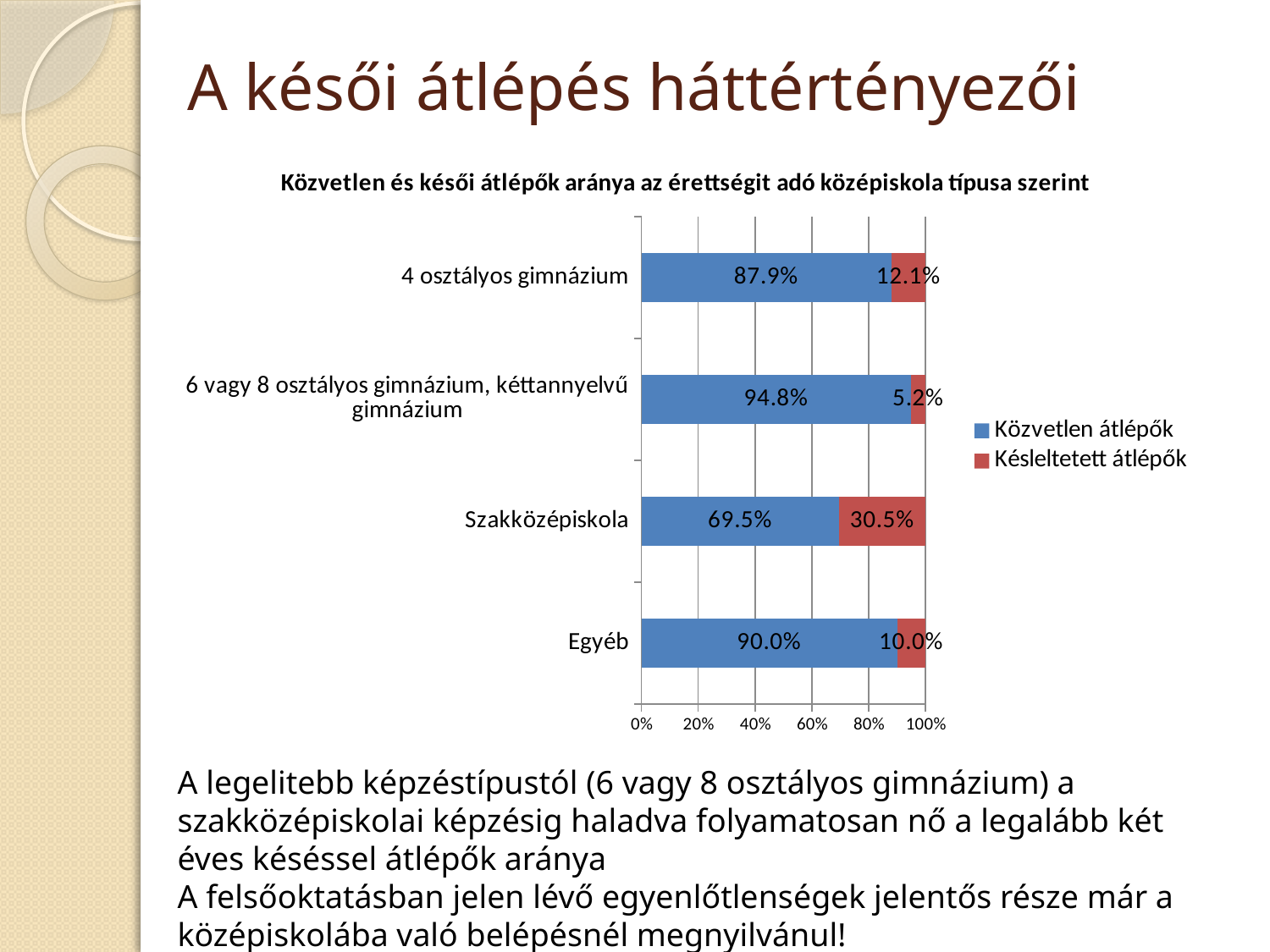
Is the Közvetlen átlépők value for Szakközépiskola greater or less than 80%? less Which category has the lowest value for Közvetlen átlépők? Szakközépiskola What kind of chart is shown on the slide? Stacked bar chart How many series does the legend list? 2 How many school-type categories are shown in the chart? 4 What is the value of Közvetlen átlépők for Szakközépiskola? 69.5% What is the difference between the Késleltetett átlépők values for Szakközépiskola and 4 osztályos gimnázium? 18.4% Which is larger: the Közvetlen átlépők value for Egyéb or for 4 osztályos gimnázium? Egyéb What is the value of Késleltetett átlépők for 4 osztályos gimnázium? 12.1% What is the value of Közvetlen átlépők for Egyéb? 90.0% What is the total of the stacked bar for 6 vagy 8 osztályos gimnázium, kéttannyelvű gimnázium? 100.0% Which category has the highest value for Késleltetett átlépők? Szakközépiskola